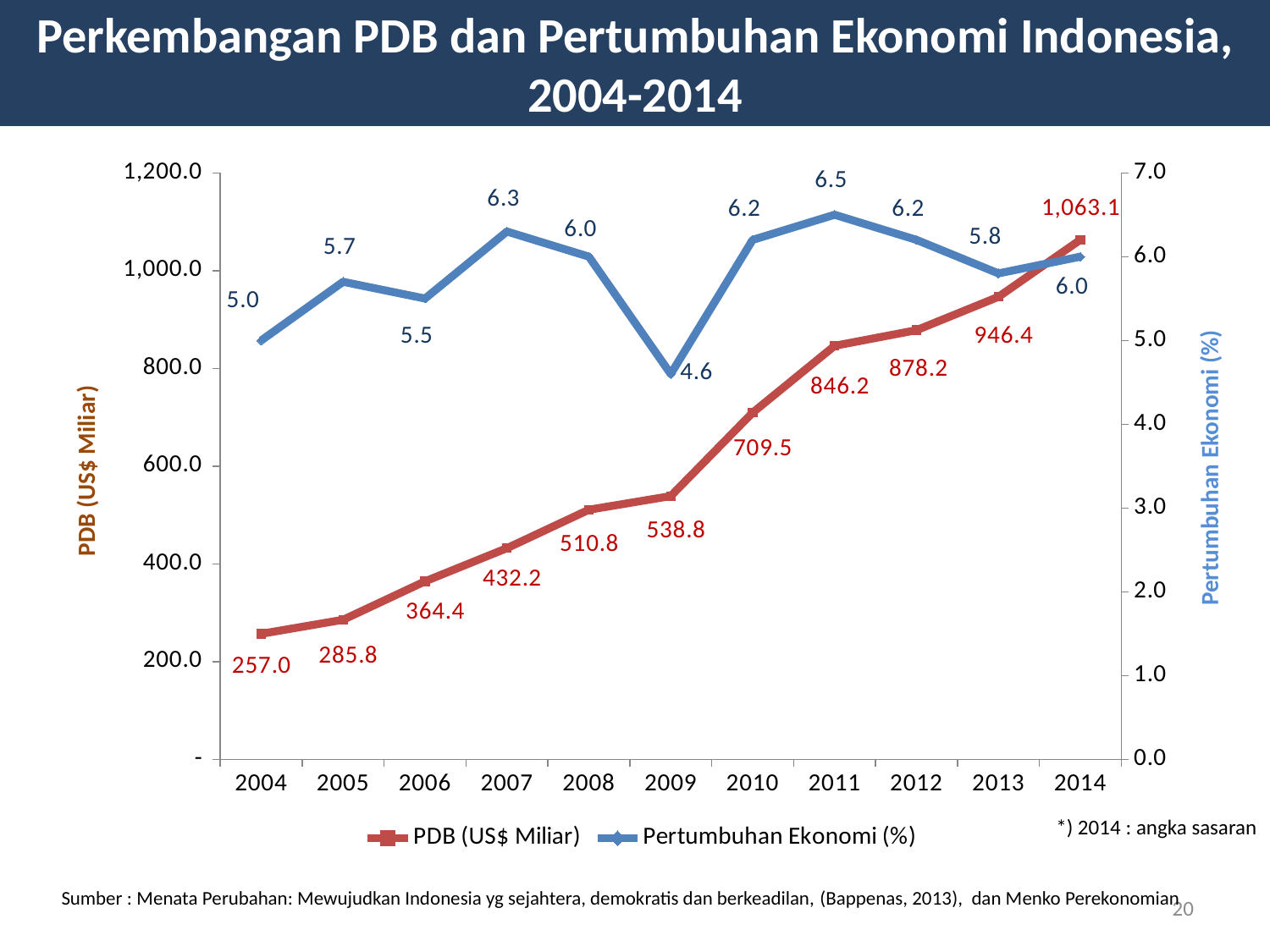
Is the PDB (US$ Miliar) value for 2011 greater or less than 800.0? greater Does PDB (US$ Miliar) rise or fall from 2004 to 2014? rise How many series does the legend list? 2 In which year is Pertumbuhan Ekonomi (%) highest? 2011 What is the Pertumbuhan Ekonomi (%) value for 2009? 4.6 How many years are shown on the x axis? 11 What is the PDB (US$ Miliar) value for 2010? 709.5 Which year has the higher Pertumbuhan Ekonomi (%): 2007 or 2013? 2007 What is the PDB (US$ Miliar) value for 2014? 1,063.1 What is the difference between the PDB (US$ Miliar) values for 2013 and 2012? 68.2 In which year is PDB (US$ Miliar) lowest? 2004 What kind of chart is shown on the slide? line chart